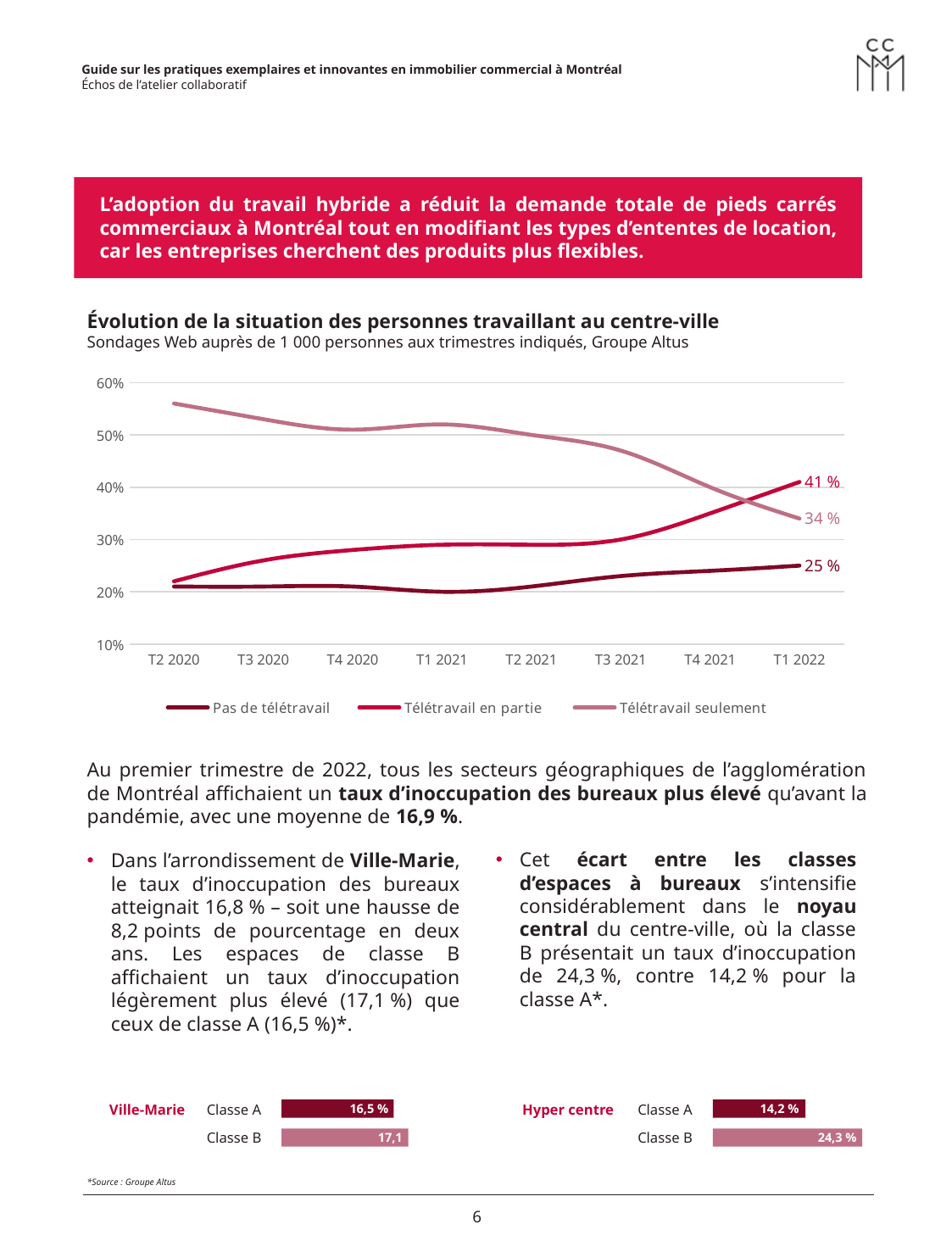
What kind of chart is 'Évolution de la situation des personnes travaillant au centre-ville'? line chart In the line chart 'Évolution de la situation des personnes travaillant au centre-ville', which series has the highest value at T1 2022? Télétravail en partie In the line chart 'Évolution de la situation des personnes travaillant au centre-ville', what is the difference between 'Télétravail en partie' and 'Télétravail seulement' at T1 2022? 7 % In the line chart 'Évolution de la situation des personnes travaillant au centre-ville', what is the value for 'Télétravail en partie' at T1 2022? 41 % In the line chart 'Évolution de la situation des personnes travaillant au centre-ville', how many quarters are shown on the x axis? 8 In the line chart 'Évolution de la situation des personnes travaillant au centre-ville', how many series does the legend list? 3 In the line chart 'Évolution de la situation des personnes travaillant au centre-ville', what is the value for 'Pas de télétravail' at T1 2022? 25 % In the line chart 'Évolution de la situation des personnes travaillant au centre-ville', is the value for 'Télétravail seulement' at T2 2020 greater or less than 50%? greater In the line chart 'Évolution de la situation des personnes travaillant au centre-ville', what is the value for 'Télétravail seulement' at T1 2022? 34 % In the 'Hyper centre' bar chart at the bottom of the slide, what is the value for Classe B? 24,3 % In the 'Ville-Marie' bar chart at the bottom of the slide, which is larger, Classe A or Classe B? Classe B In the line chart 'Évolution de la situation des personnes travaillant au centre-ville', does the 'Télétravail seulement' series rise or fall from T2 2020 to T1 2022? fall